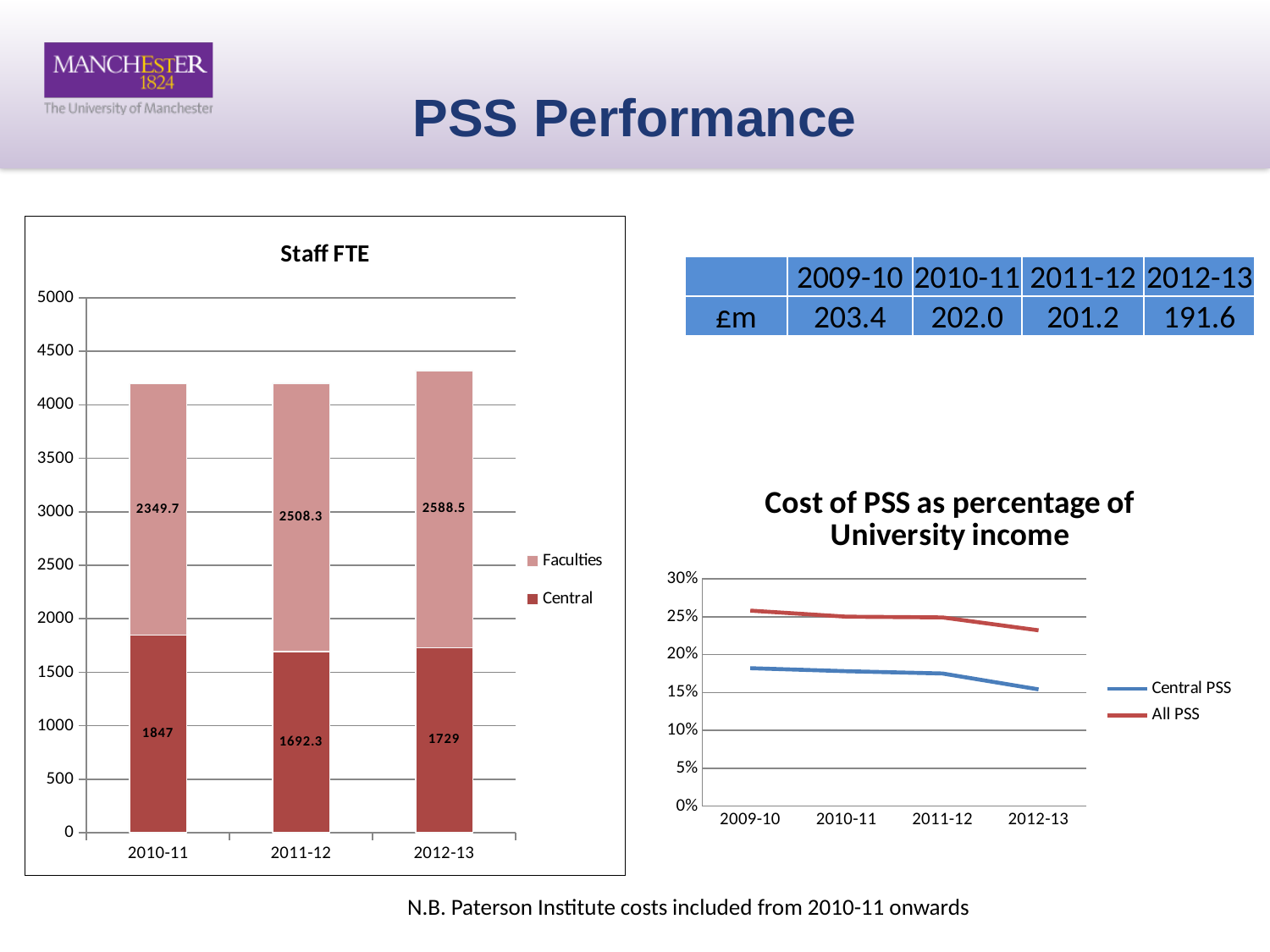
In the Staff FTE chart, what is the Faculties value for 2012-13? 2588.5 In the Staff FTE chart, what is the Central value for 2010-11? 1847 What kind of chart is the Staff FTE chart? Stacked bar chart In the Staff FTE chart, what is the Central value for 2011-12? 1692.3 In the Cost of PSS as percentage of University income chart, is the Central PSS value for 2012-13 greater or less than 20%? less In the Staff FTE chart, which year has the highest Faculties value? 2012-13 In the Staff FTE chart, which year has the lowest Central value? 2011-12 How many series does the legend of the Cost of PSS as percentage of University income chart list? 2 In the Staff FTE chart, what is the difference between the Faculties values for 2012-13 and 2010-11? 238.8 In the Staff FTE chart, is the Faculties value for 2011-12 larger than the Central value for 2011-12? Yes, Faculties (2508.3) In the Cost of PSS as percentage of University income chart, does the All PSS line rise or fall from 2009-10 to 2012-13? Falls In the Staff FTE chart, what is the total of the stacked bar for 2010-11? 4196.7